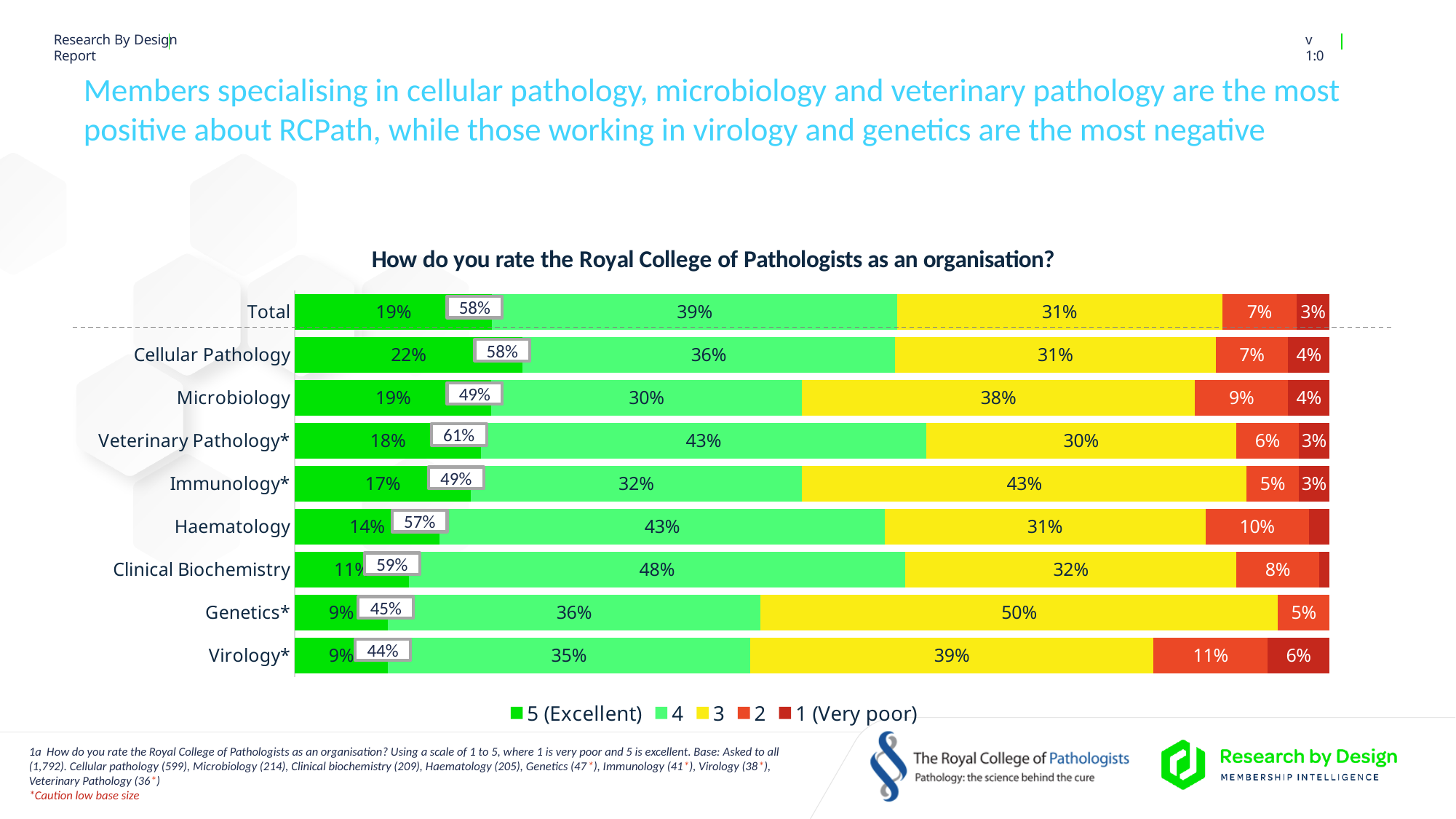
Which specialty has the highest percentage of 5 (Excellent) ratings? Cellular Pathology Which specialty has the highest percentage of 2 ratings? Virology* What percentage of Genetics* members gave a rating of 3? 50% What is the value for the 4 rating in the Clinical Biochemistry bar? 48% What is the title of the chart? How do you rate the Royal College of Pathologists as an organisation? What percentage of Cellular Pathology members rated the Royal College of Pathologists 5 (Excellent)? 22% What is the difference between the 3 rating for Genetics* and the 3 rating for Total? 19 percentage points What percentage of Virology* members gave a rating of 1 (Very poor)? 6% How many series does the legend list? 5 What kind of chart is shown on the slide? Stacked bar chart How many categories (rows) are shown in the chart, including Total? 9 Which is larger: the 4 rating for Haematology or the 4 rating for Microbiology? Haematology